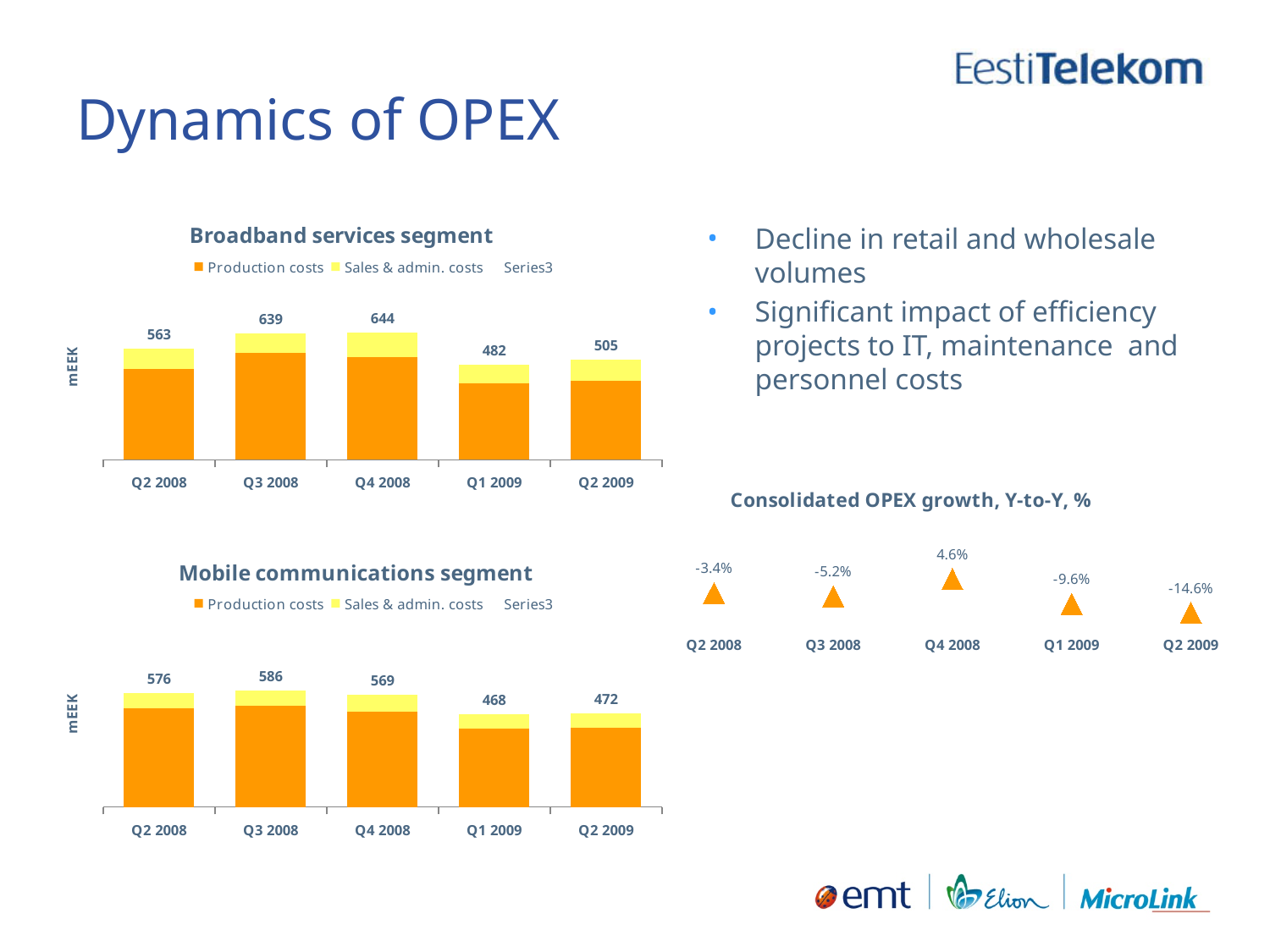
In the Mobile communications segment chart, what is the total value labelled for Q3 2008? 586 In the Mobile communications segment chart, what is the difference between the labelled totals for Q2 2008 and Q2 2009? 104 In the Consolidated OPEX growth, Y-to-Y, % chart, which quarter has the highest value? Q4 2008 What kind of chart is the Broadband services segment chart? Stacked bar chart In the Broadband services segment chart, what is the total value labelled for Q4 2008? 644 In the Broadband services segment chart, what is the difference between the labelled totals for Q4 2008 and Q1 2009? 162 In the Broadband services segment chart, which quarter has the lowest labelled total? Q1 2009 In the Consolidated OPEX growth, Y-to-Y, % chart, what is the value for Q2 2009? -14.6% In the Mobile communications segment chart, how many quarters are shown on the x axis? 5 In the Mobile communications segment chart, which quarter has the highest labelled total? Q3 2008 What unit is shown on the y axis of the Mobile communications segment chart? mEEK In the Consolidated OPEX growth, Y-to-Y, % chart, which is larger, the value for Q2 2008 or the value for Q1 2009? Q2 2008